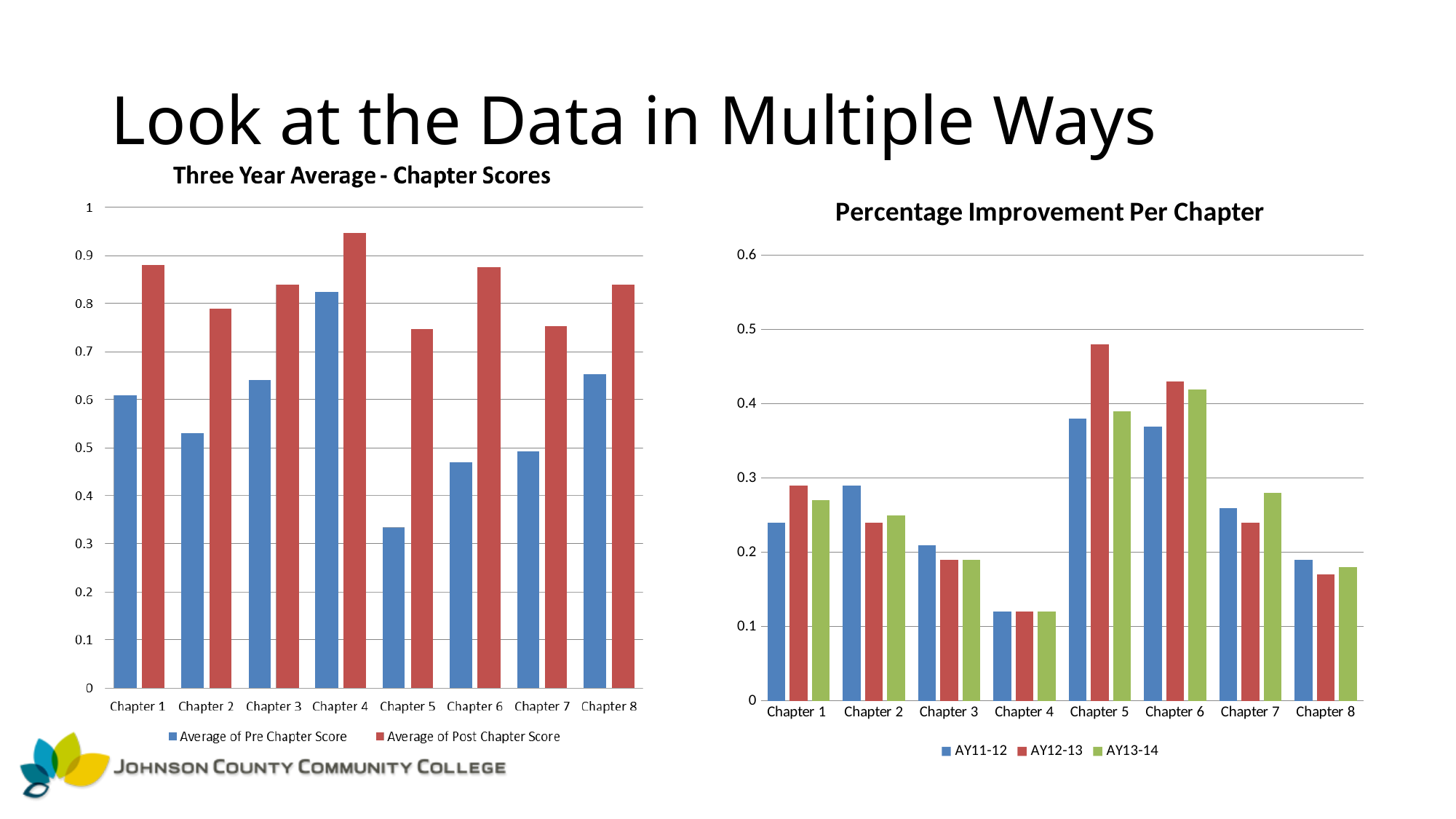
In the 'Three Year Average - Chapter Scores' chart, which chapter has the highest Average of Post Chapter Score? Chapter 4 In the 'Three Year Average - Chapter Scores' chart, is the Average of Pre Chapter Score for Chapter 5 greater or less than 0.4? less How many series does the legend of the 'Percentage Improvement Per Chapter' chart list? 3 In the 'Percentage Improvement Per Chapter' chart, which chapter has the highest AY12-13 value? Chapter 5 How many series does the legend of the 'Three Year Average - Chapter Scores' chart list? 2 In the 'Percentage Improvement Per Chapter' chart, is the AY13-14 value for Chapter 6 greater or less than 0.4? greater In the 'Three Year Average - Chapter Scores' chart, is the Average of Post Chapter Score for Chapter 1 greater or less than 0.8? greater In the 'Three Year Average - Chapter Scores' chart, which chapter has the lowest Average of Pre Chapter Score? Chapter 5 What kind of chart is the 'Three Year Average - Chapter Scores' chart? bar chart In the 'Percentage Improvement Per Chapter' chart, which chapter has the lowest AY11-12 value? Chapter 4 In the 'Three Year Average - Chapter Scores' chart, which chapter has the highest Average of Pre Chapter Score? Chapter 4 How many chapters are shown on the x axis of the 'Percentage Improvement Per Chapter' chart? 8